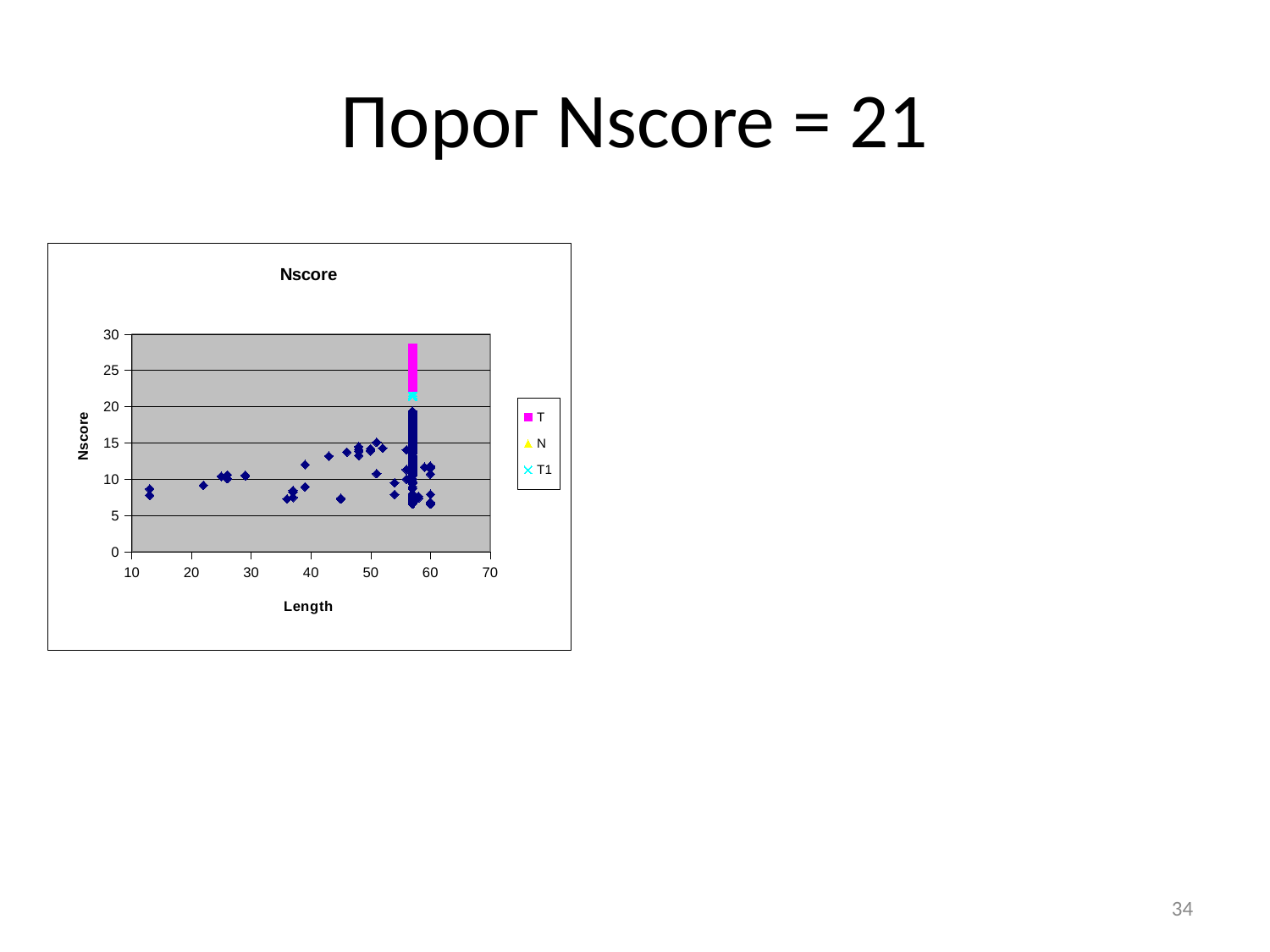
How many series does the legend of the chart list? 3 Are the magenta T points greater or less than 30 on the Nscore axis? less What kind of chart is shown on the slide? scatter chart What is the label of the horizontal axis of the chart? Length Is the cyan T1 point greater or less than 20 on the Nscore axis? greater What is the title of the chart? Nscore Are the magenta T points in the chart greater or less than 20 on the Nscore axis? greater Which series in the chart has the highest Nscore values, T or N? T